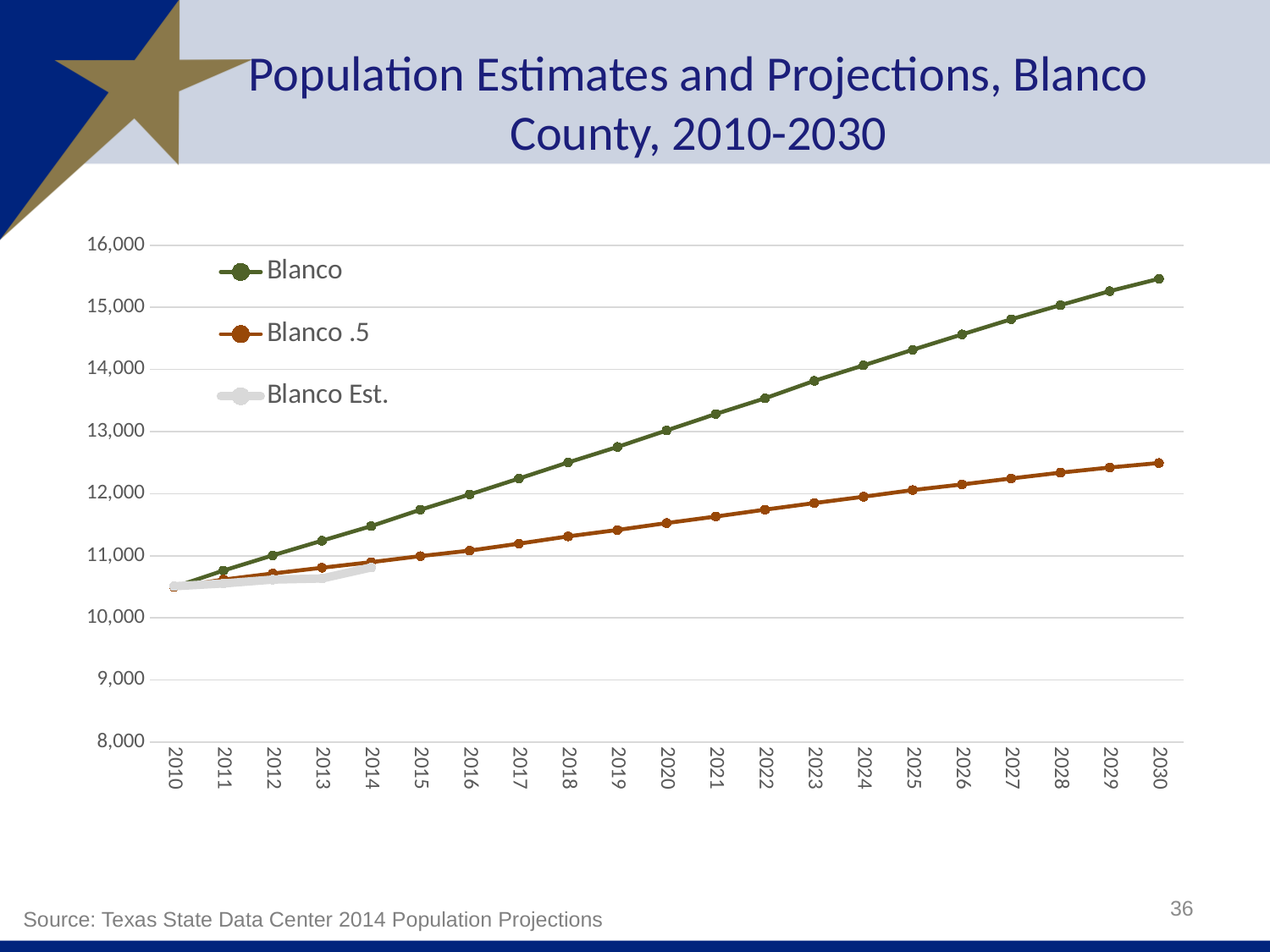
Is the value for Blanco .5 in 2020 greater or less than 12,000? less What is the title of the chart on the slide? Population Estimates and Projections, Blanco County, 2010-2030 Do the values for the Blanco series rise or fall from 2010 to 2030? rise In 2030, which series has the larger value, Blanco or Blanco .5? Blanco How many years are plotted along the x axis? 21 How many series does the legend list? 3 Is the value for Blanco in 2030 greater or less than 15,000? greater Is the value for Blanco .5 in 2030 greater or less than 13,000? less What kind of chart is shown on the slide? line chart In which year does the Blanco series reach its highest value? 2030 In which year is the Blanco .5 series at its lowest value? 2010